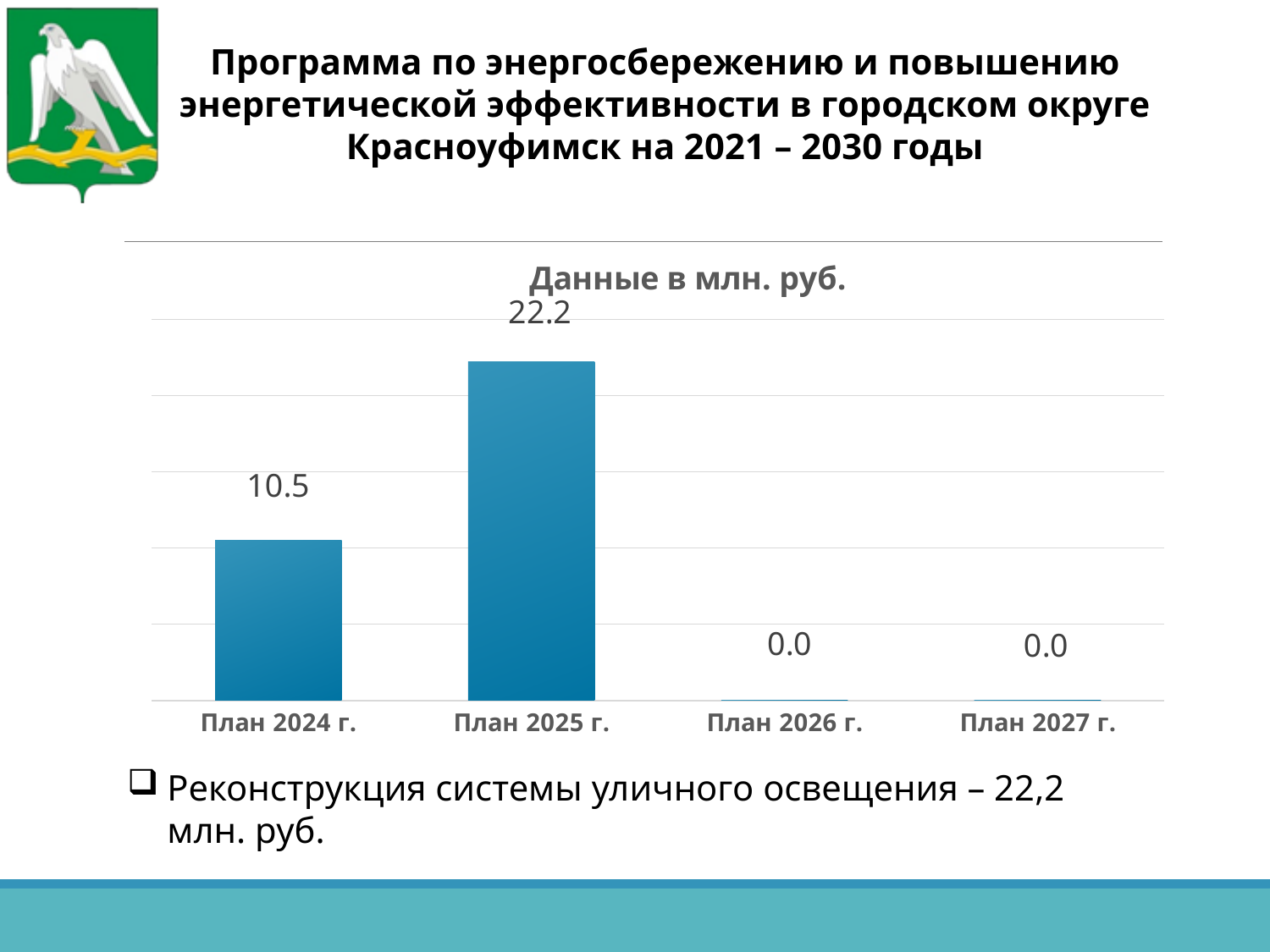
What is the value for План 2026 г.? 0.0 What is the value for План 2024 г.? 10.5 How many categories are shown on the x axis? 4 What is the title of the chart? Данные в млн. руб. What is the total of the values for План 2024 г. and План 2025 г.? 32.7 What is the difference between the values for План 2025 г. and План 2024 г.? 11.7 What kind of chart is shown on the slide? Bar chart Does the value rise or fall from План 2025 г. to План 2026 г.? Fall Which category has the highest value? План 2025 г. How many categories have a value of 0.0? 2 Which is larger, the value for План 2024 г. or the value for План 2025 г.? План 2025 г. What is the value for План 2025 г.? 22.2